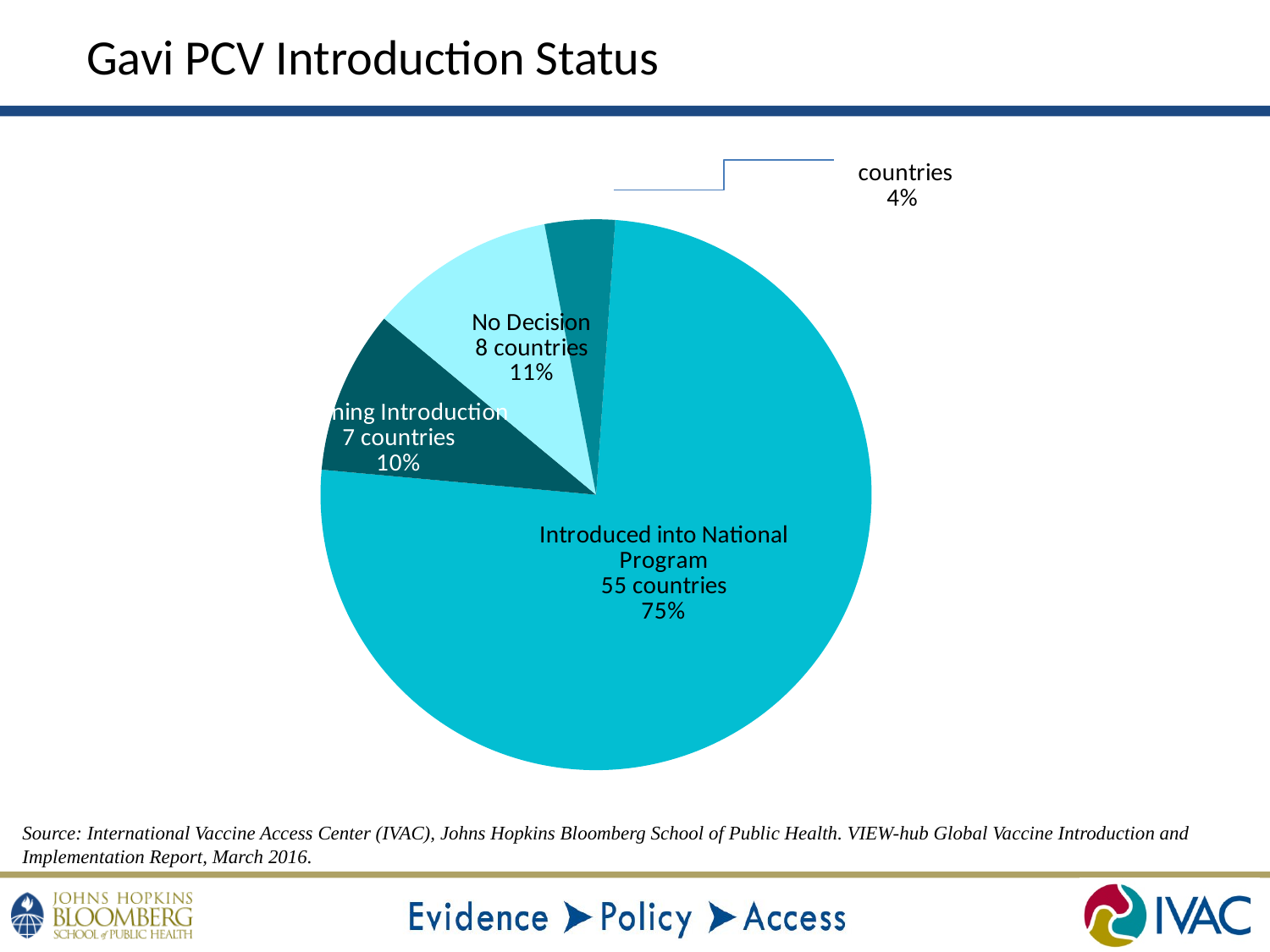
What percentage of the pie is the No Decision slice? 11% What percentage of the pie is the slice with 7 countries? 10% What share of the pie does Introduced into National Program represent? 75% What kind of chart is shown on the slide? pie chart How many countries are in the Introduced into National Program slice? 55 countries Which has more countries, No Decision or the slice with 7 countries? No Decision How many more countries are in Introduced into National Program than in No Decision? 47 How many countries are in the No Decision slice? 8 countries What is the title of the slide? Gavi PCV Introduction Status What is the difference in percentage points between the No Decision slice and the 10% slice? 1% How many slices does the pie chart have? 4 Which category has the largest slice of the pie? Introduced into National Program